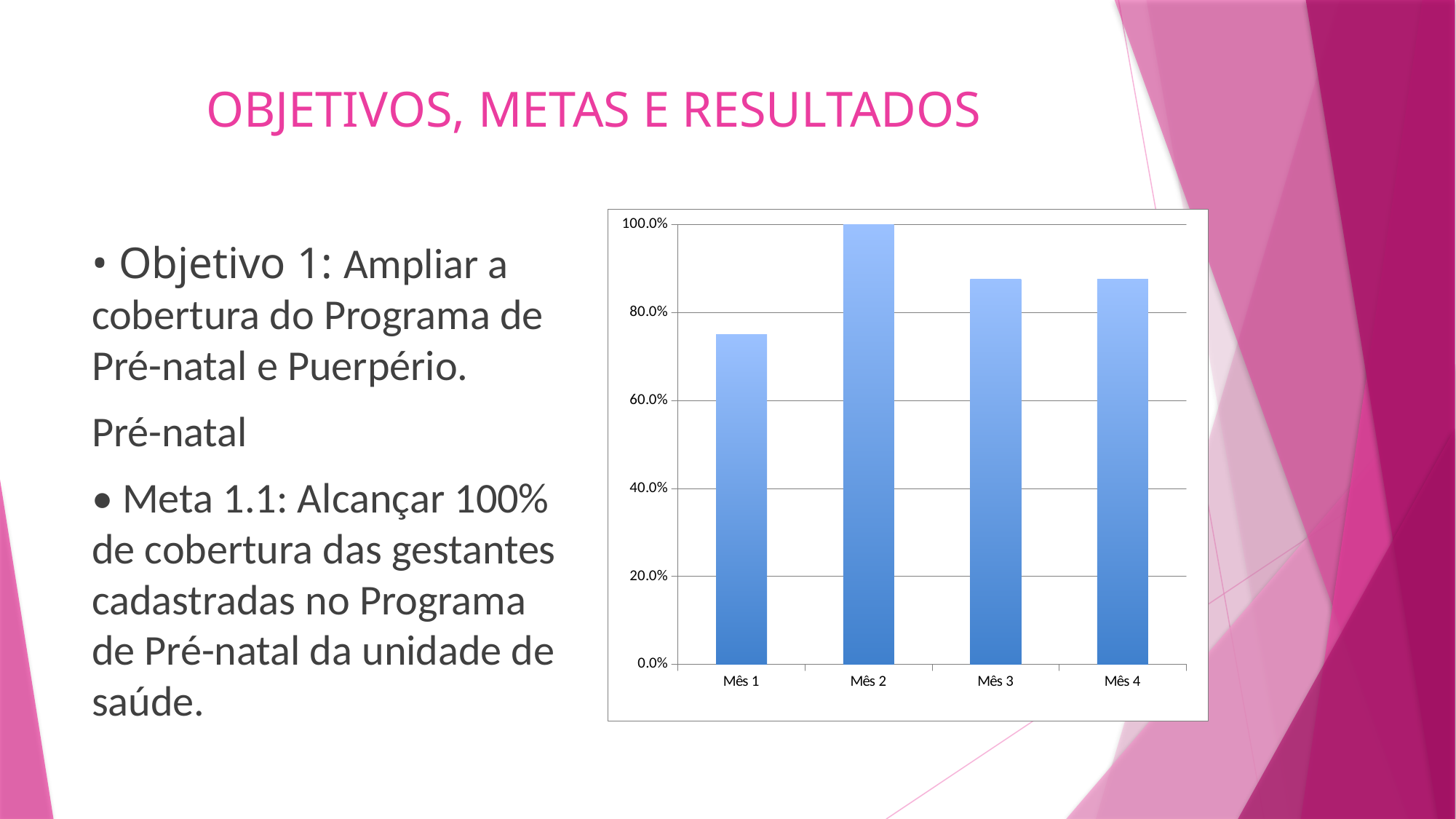
What kind of chart is shown on the slide? bar chart How many categories (months) are plotted on the chart? 4 Is the value for Mês 4 greater or less than 100.0%? less Is the value for Mês 1 greater or less than 80.0%? less Is the value for Mês 1 greater or less than 60.0%? greater Does the value rise or fall from Mês 1 to Mês 2? rise Which is larger, the value for Mês 1 or the value for Mês 3? Mês 3 Which month has the highest bar on the chart? Mês 2 Which month has the lowest bar on the chart? Mês 1 What value does the bar for Mês 2 reach on the chart? 100.0% What is the highest value shown on the chart's vertical axis? 100.0%